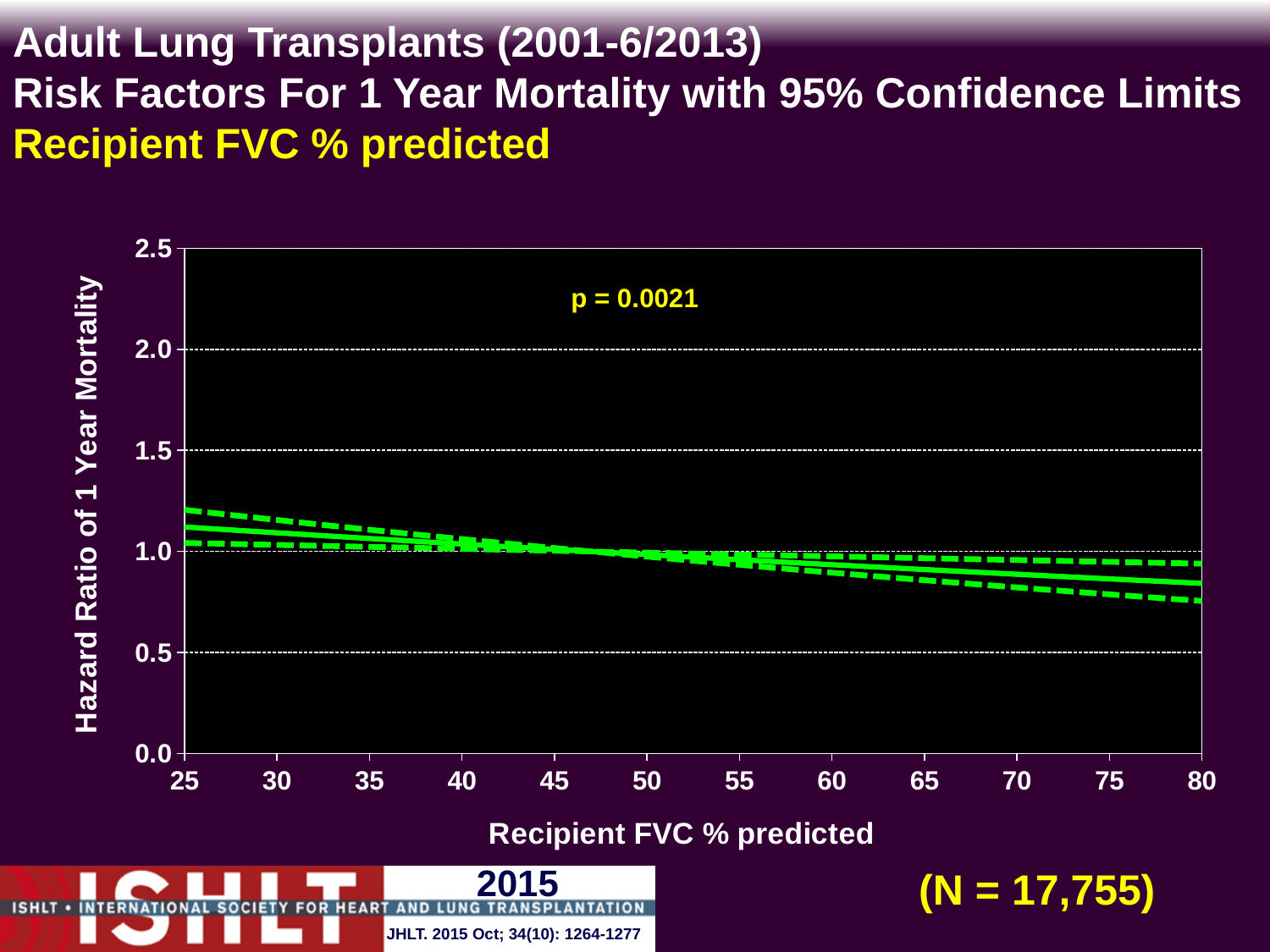
What p-value is printed on the chart? p = 0.0021 Is the hazard ratio at a Recipient FVC % predicted of 25 greater or less than 1.0? greater Is the hazard ratio at a Recipient FVC % predicted of 80 greater or less than 1.0? less Does the hazard ratio of 1 year mortality rise or fall as Recipient FVC % predicted increases from 25 to 80? Fall What is the highest value shown on the y axis? 2.5 Is the hazard ratio at a Recipient FVC % predicted of 25 greater or less than 1.5? less What kind of chart is shown on the slide? Line chart What is the label of the y axis? Hazard Ratio of 1 Year Mortality What is the sample size (N) shown on the slide? N = 17,755 What is the range of Recipient FVC % predicted shown on the x axis? 25 to 80 Which has the higher hazard ratio: a Recipient FVC % predicted of 30 or of 70? 30